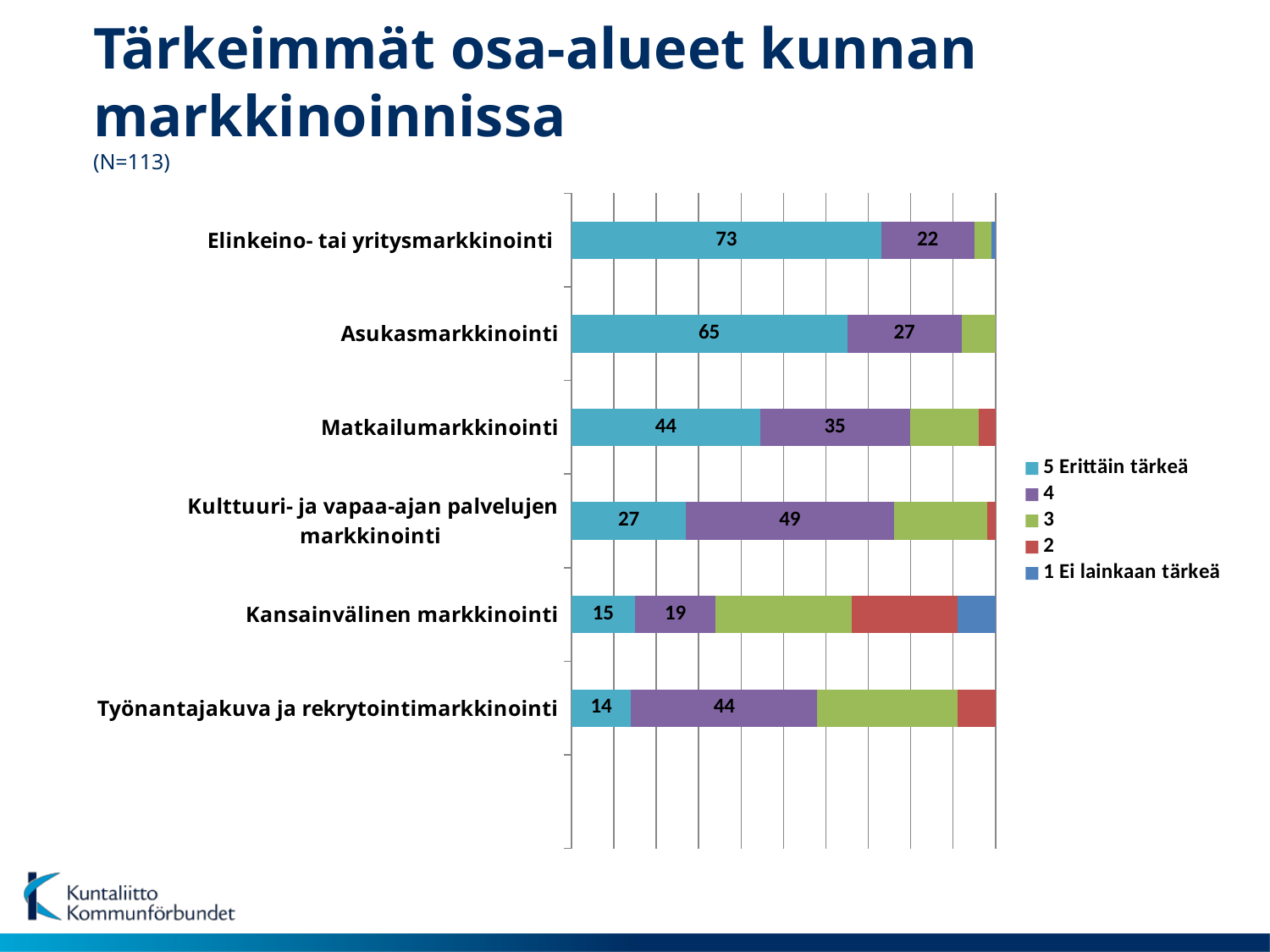
Which category has the lowest value for the '5 Erittäin tärkeä' series? Työnantajakuva ja rekrytointimarkkinointi Which category has the highest value for the '5 Erittäin tärkeä' series? Elinkeino- tai yritysmarkkinointi How many series does the legend list? 5 Which is larger: the '4' value for Matkailumarkkinointi or the '4' value for Kulttuuri- ja vapaa-ajan palvelujen markkinointi? Kulttuuri- ja vapaa-ajan palvelujen markkinointi What is the value of the '4' segment for Asukasmarkkinointi? 27 What is the sample size (N) stated on the slide? N=113 What kind of chart is shown on the slide? Stacked bar chart What is the value of the '5 Erittäin tärkeä' segment for Kulttuuri- ja vapaa-ajan palvelujen markkinointi? 27 What is the value of the '4' segment for Työnantajakuva ja rekrytointimarkkinointi? 44 What is the difference between the '5 Erittäin tärkeä' values for Elinkeino- tai yritysmarkkinointi and Asukasmarkkinointi? 8 How many categories are plotted in the chart? 6 What is the value of the '5 Erittäin tärkeä' segment for Elinkeino- tai yritysmarkkinointi? 73